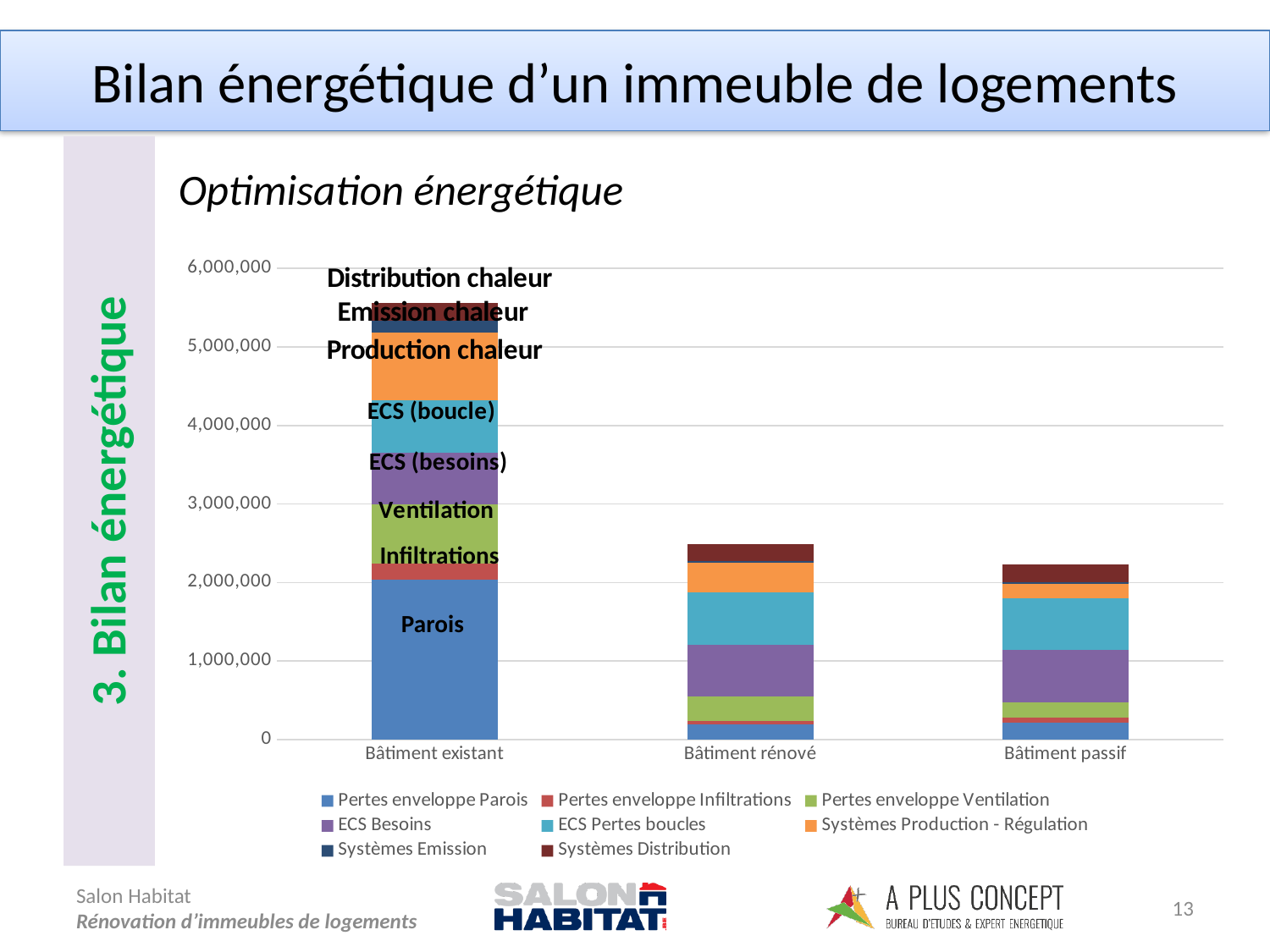
What is the title shown above the chart? Optimisation énergétique Which building category has the lowest total bar? Bâtiment passif Which has a larger total bar, Bâtiment existant or Bâtiment rénové? Bâtiment existant Do the total bar heights rise or fall from Bâtiment existant to Bâtiment passif along the x axis? fall Is the total for Bâtiment existant greater or less than 5,000,000? greater How many building categories are shown on the x axis of the chart? 3 Which legend entry corresponds to the bottom (blue) segment of each bar? Pertes enveloppe Parois What kind of chart is shown on the slide? stacked bar chart Which building category has the highest total bar? Bâtiment existant How many series does the chart legend list? 8 Is the total for Bâtiment rénové greater or less than 3,000,000? less Is the total for Bâtiment passif greater or less than 2,000,000? greater